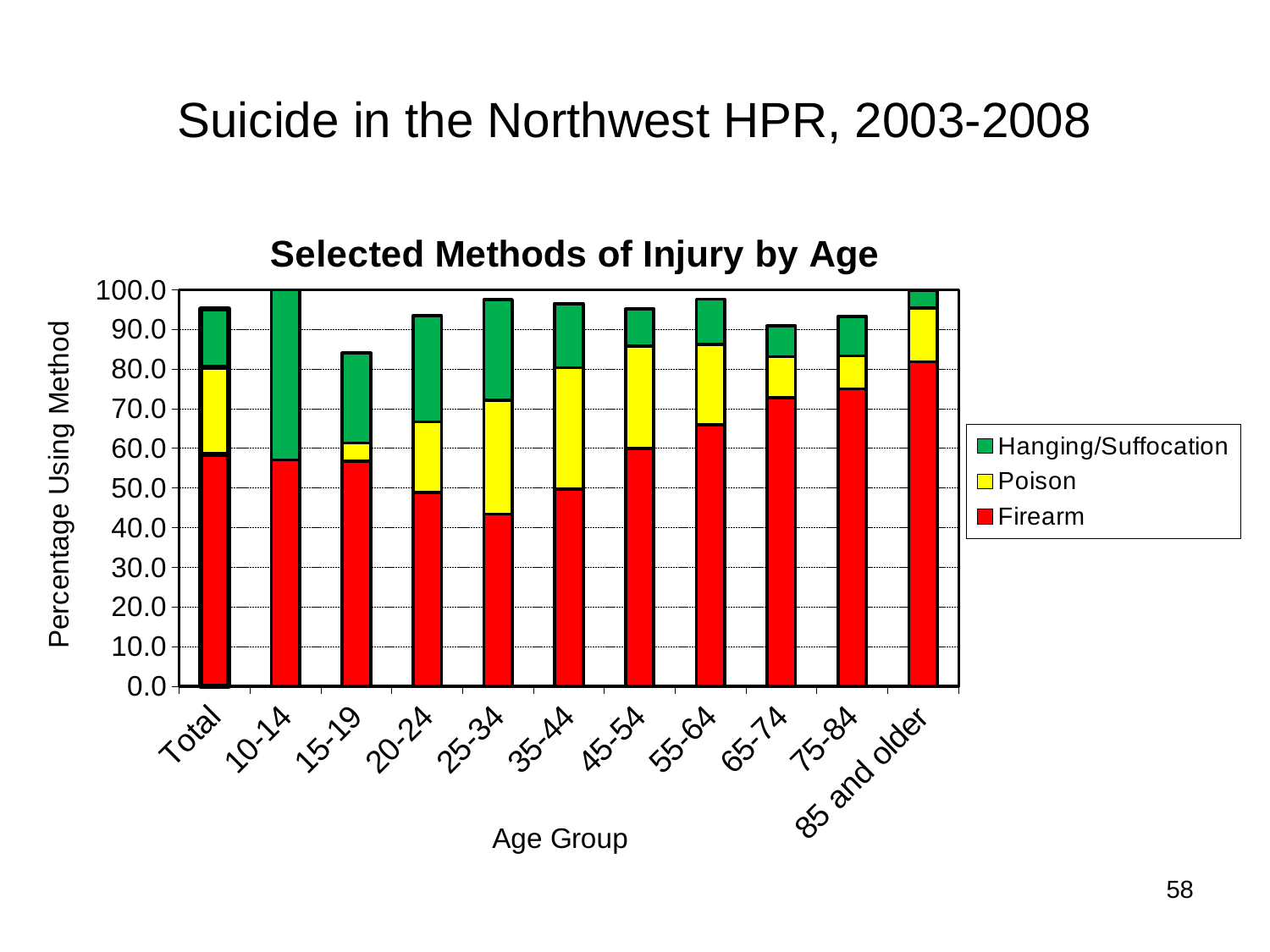
Which is larger, the Hanging/Suffocation segment for 10-14 or for 15-19? 10-14 What colour represents Poison in the chart? Yellow Is the Firearm value for 85 and older greater or less than 70.0? greater Which age group has the lowest Firearm percentage? 25-34 What is the title of the chart? Selected Methods of Injury by Age Which is larger, the Firearm value for 75-84 or for 20-24? 75-84 What kind of chart is shown on the slide? Stacked bar chart Is the Firearm value for 25-34 greater or less than 50.0? less Is the Firearm value for 65-74 greater or less than 70.0? greater How many series does the legend list? 3 How many age-group categories are shown on the x axis of the chart? 11 Which age group has the highest Firearm percentage? 85 and older